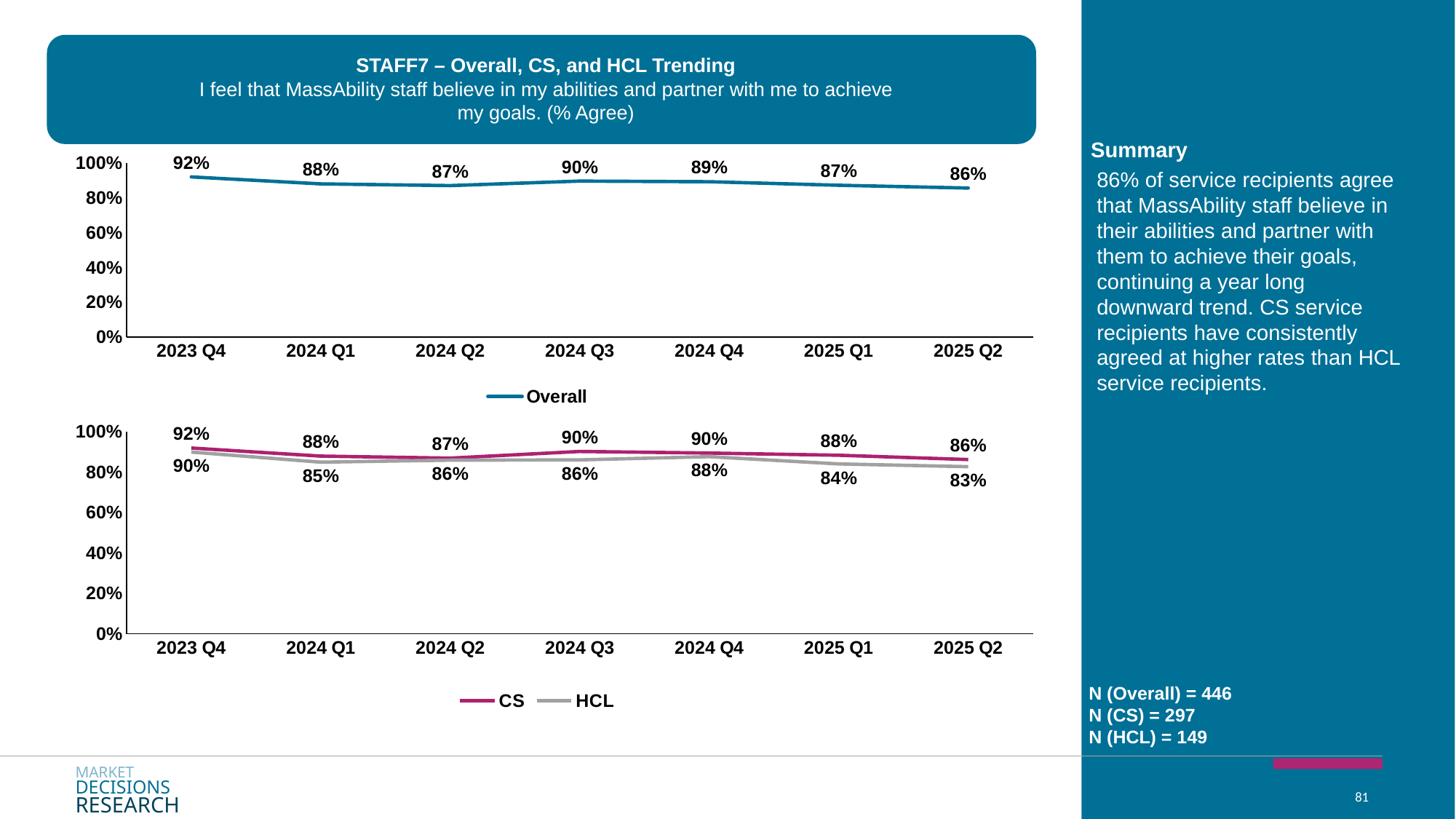
In the bottom chart, what is the HCL value for 2025 Q1? 84% In the top chart (Overall), which quarter has the lowest value? 2025 Q2 In the top chart (Overall), what is the value for 2025 Q2? 86% In the bottom chart, what is the CS value for 2024 Q3? 90% In the top chart (Overall), which quarter has the highest value? 2023 Q4 In the top chart (Overall), what is the value for 2023 Q4? 92% In the bottom chart, which series has the higher value in 2025 Q2, CS or HCL? CS In the bottom chart, what is the difference between the CS and HCL values in 2025 Q1? 4% In the top chart (Overall), what is the difference between the 2023 Q4 value and the 2025 Q2 value? 6% How many quarters are plotted on the x axis of the top chart? 7 In the bottom chart, how many series does the legend list? 2 What type of chart is the top chart? Line chart